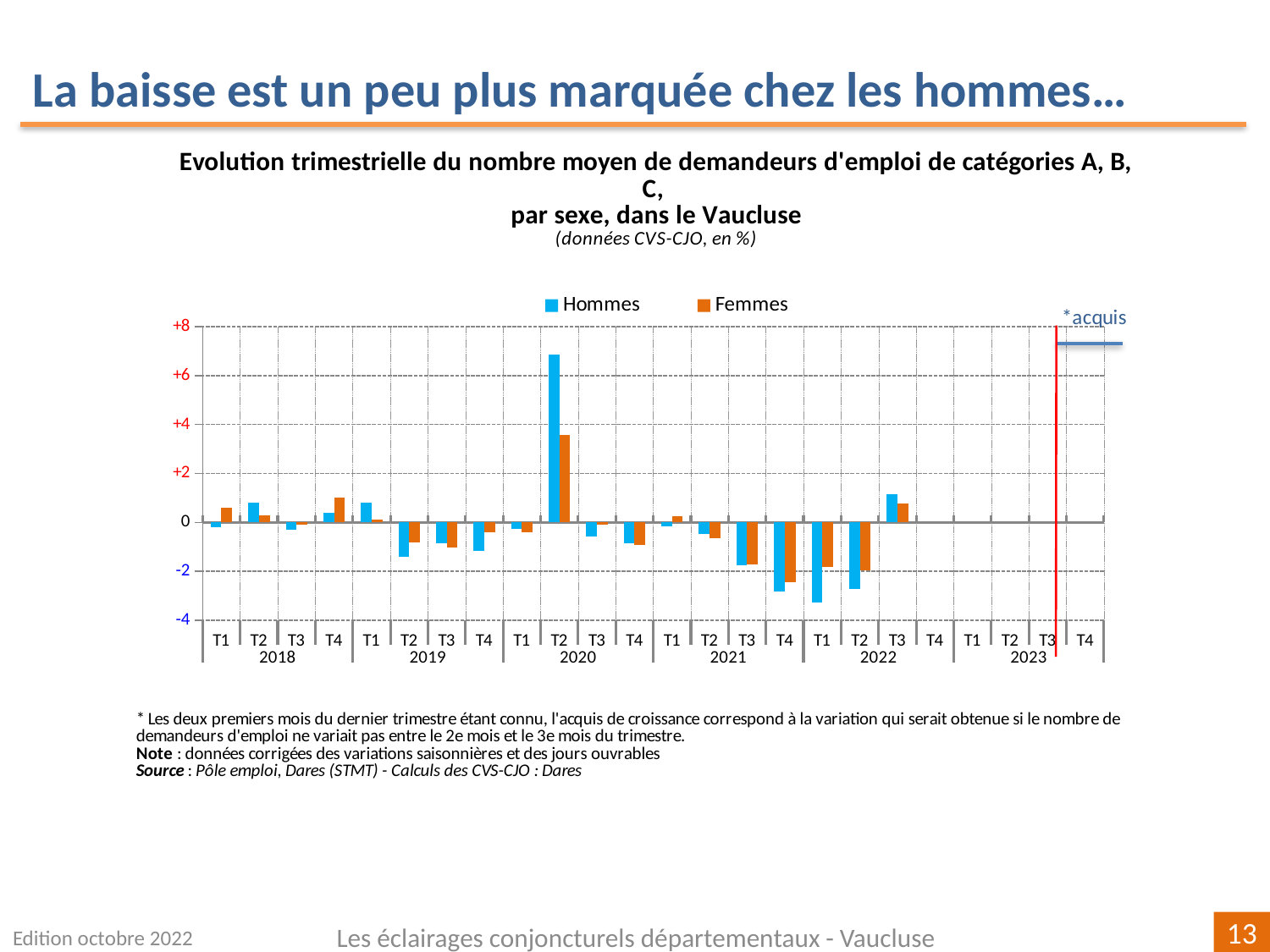
How many series does the legend list? 2 In T4 2019, which series has the larger value, Hommes or Femmes? Femmes What kind of chart is shown on the slide? bar chart In which quarter is the value for Femmes highest? T2 2020 Is the value for Hommes in T1 2022 greater or less than -2? less In which quarter is the value for Hommes lowest? T1 2022 Is the value for Hommes in T2 2020 greater or less than +6? greater In T2 2020, which series has the larger value, Hommes or Femmes? Hommes How many years are labelled along the x axis? 6 Is the value for Femmes in T2 2020 greater or less than +4? less Which series is shown in blue? Hommes In which quarter is the value for Hommes highest? T2 2020